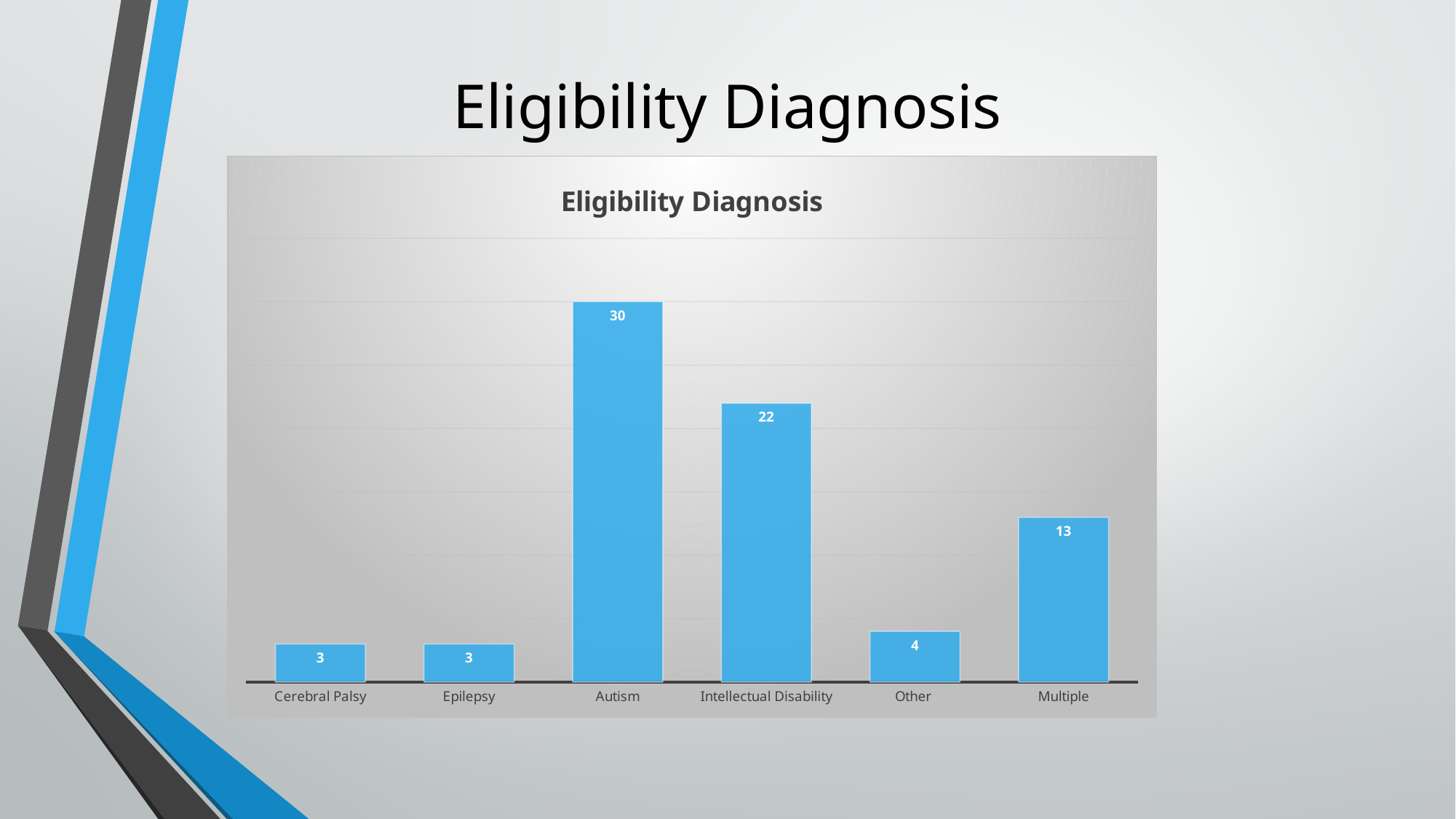
What is the title of the chart? Eligibility Diagnosis What is the value for Multiple? 13 What is the value for Other? 4 What is the difference between the values for Autism and Intellectual Disability? 8 Which is larger, the value for Intellectual Disability or the value for Multiple? Intellectual Disability What is the difference between the values for Multiple and Other? 9 Do Cerebral Palsy and Epilepsy have the same value? Yes What is the value for Intellectual Disability? 22 Which category has the highest value? Autism What kind of chart is shown on the slide? Bar chart What is the value for Autism? 30 How many categories are shown on the x axis? 6